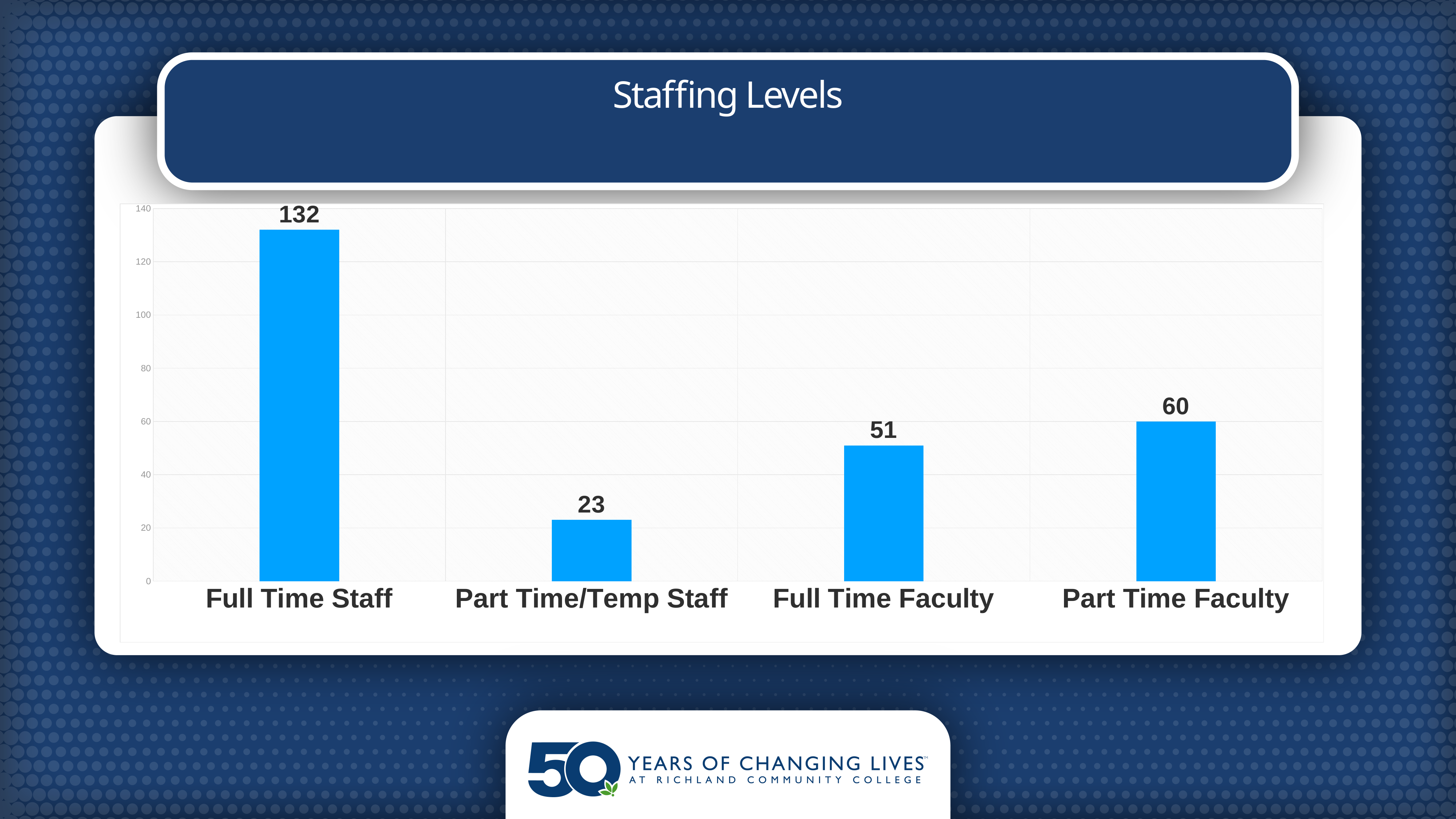
Which is larger, Full Time Faculty or Part Time Faculty? Part Time Faculty What is the difference between Full Time Staff and Full Time Faculty? 81 Is the value for Full Time Staff greater or less than 120? greater Which category has the highest value? Full Time Staff What is the value for Part Time Faculty? 60 What is the value for Part Time/Temp Staff? 23 What is the value for Full Time Staff? 132 What kind of chart is shown on the slide? bar chart Which category has the lowest value? Part Time/Temp Staff What is the difference between Part Time Faculty and Part Time/Temp Staff? 37 How many categories are shown in the chart? 4 What is the value for Full Time Faculty? 51